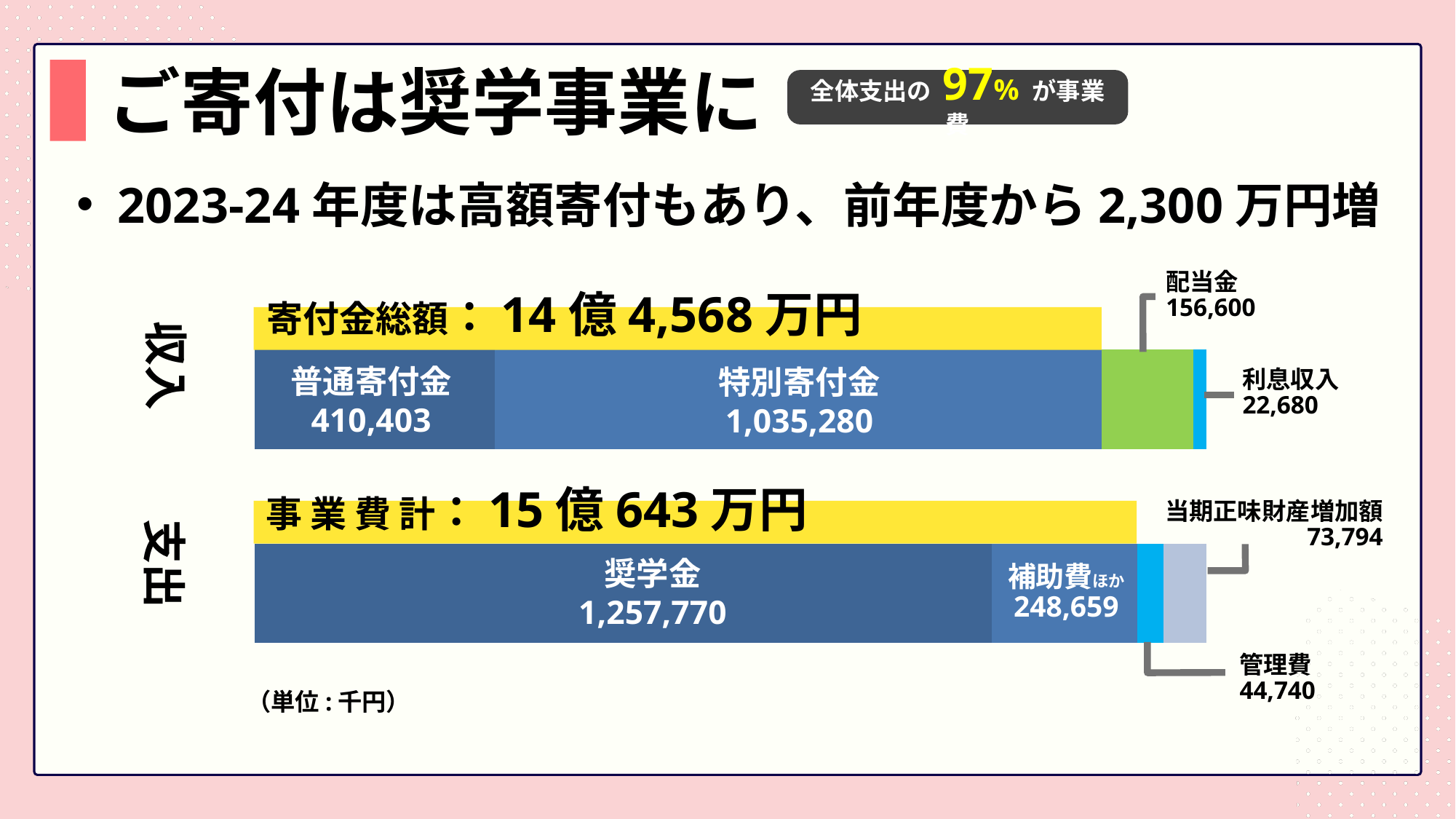
In the 支出 bar, what is the value for 奨学金? 1,257,770 What kind of chart is used to show 収入 and 支出 on this slide? Stacked bar chart Which segment of the 収入 bar is the largest? 特別寄付金 In the 支出 bar, which is larger, 補助費ほか or 当期正味財産増加額? 補助費ほか Which segment of the 支出 bar is the smallest? 管理費 In the 収入 bar, what is the value for 普通寄付金? 410,403 What unit are the values in the chart expressed in? 千円 In the 支出 bar, what is the value for 管理費? 44,740 In the 収入 bar, what is the value for 特別寄付金? 1,035,280 In the 収入 bar, what is the value for 配当金? 156,600 In the 収入 bar, what is the difference between 特別寄付金 and 普通寄付金? 624,877 How many segments make up the 支出 bar? 4